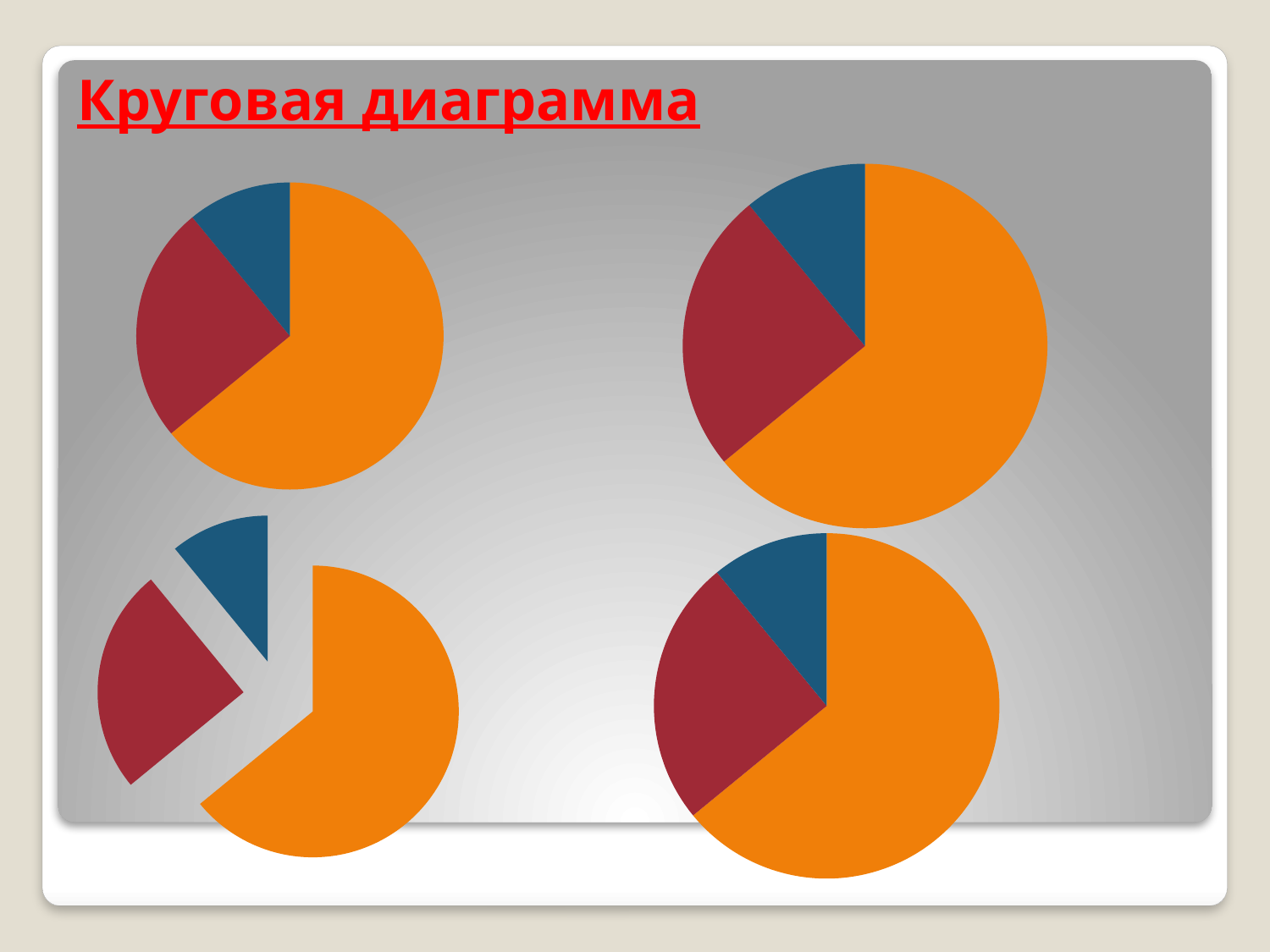
What kind of chart is shown in the top-left of the slide? pie chart In the top-left pie chart, which colour slice is the largest? orange In the bottom-right pie chart, is the orange slice more or less than half of the pie? more In the bottom-left pie chart, which slice is larger, the red one or the blue one? red In the top-right pie chart, which colour slice is the largest? orange In the bottom-right pie chart, which colour slice is the smallest? blue Which of the four pie charts has its slices pulled apart (exploded)? bottom-left What is the title of the slide? Круговая диаграмма How many slices does the top-right pie chart have? 3 In the top-left pie chart, which colour slice is the smallest? blue How many pie charts are shown on the slide? 4 How many slices does the top-left pie chart have? 3